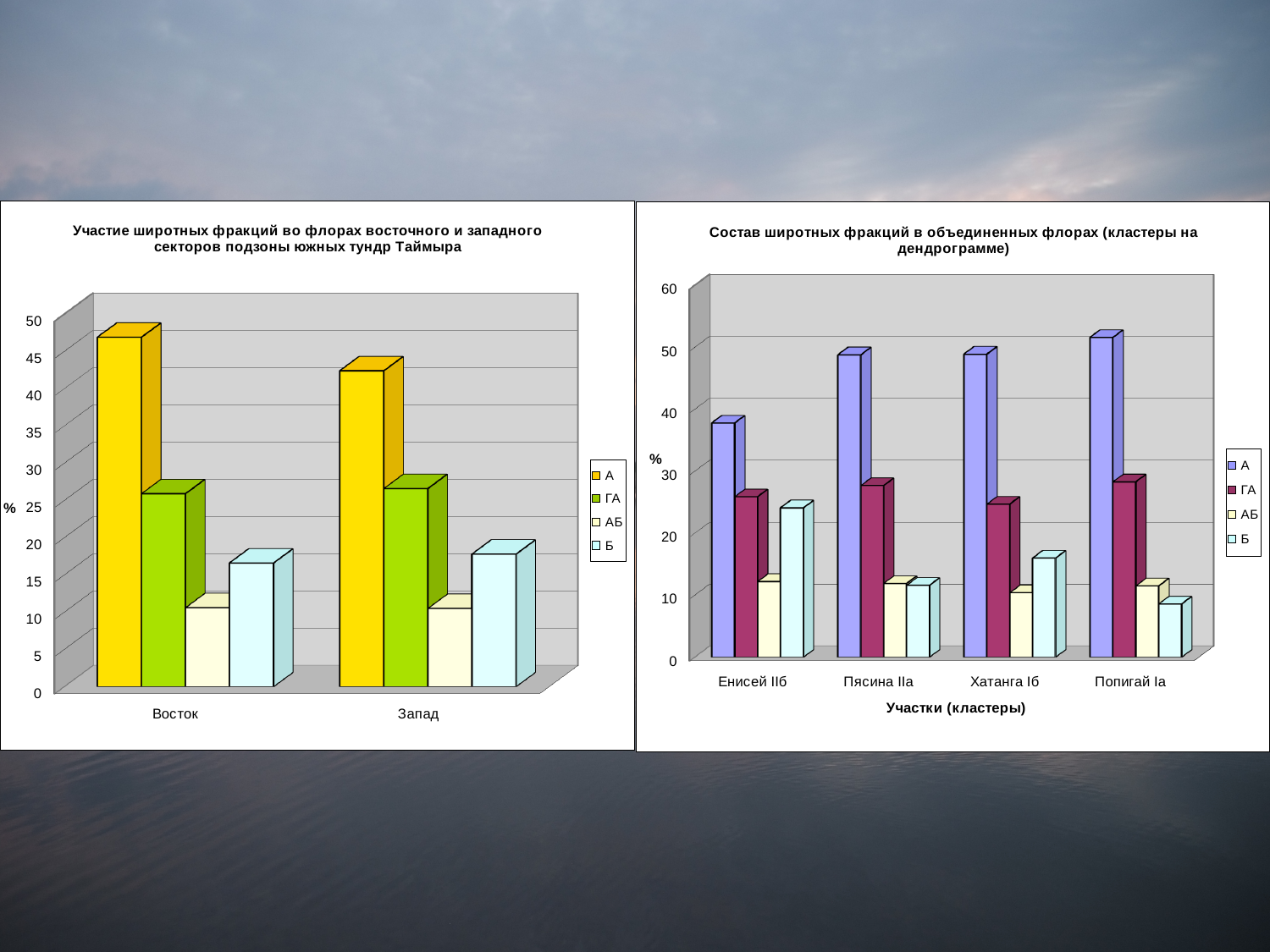
In the left chart, which series has the lowest value for Восток? АБ In the right chart, which is larger for Хатанга Iб: series ГА or series Б? ГА In the left chart, is the value of series АБ for Запад greater or less than 15? less How many series does the legend of the left chart list? 4 What is the x-axis title of the right chart? Участки (кластеры) In the right chart, which category has the lowest value for series Б? Попигай Iа What kind of chart is the left chart, 'Участие широтных фракций во флорах восточного и западного секторов подзоны южных тундр Таймыра'? Bar chart In the right chart, which category has the highest value for series А? Попигай Iа How many categories are shown on the x axis of the right chart, 'Состав широтных фракций в объединенных флорах'? 4 In the left chart, which series has the highest value for Запад? А In the left chart, is the value of series А for Восток greater or less than 40? greater In the right chart, is the value of series Б for Енисей IIб greater or less than 20? greater